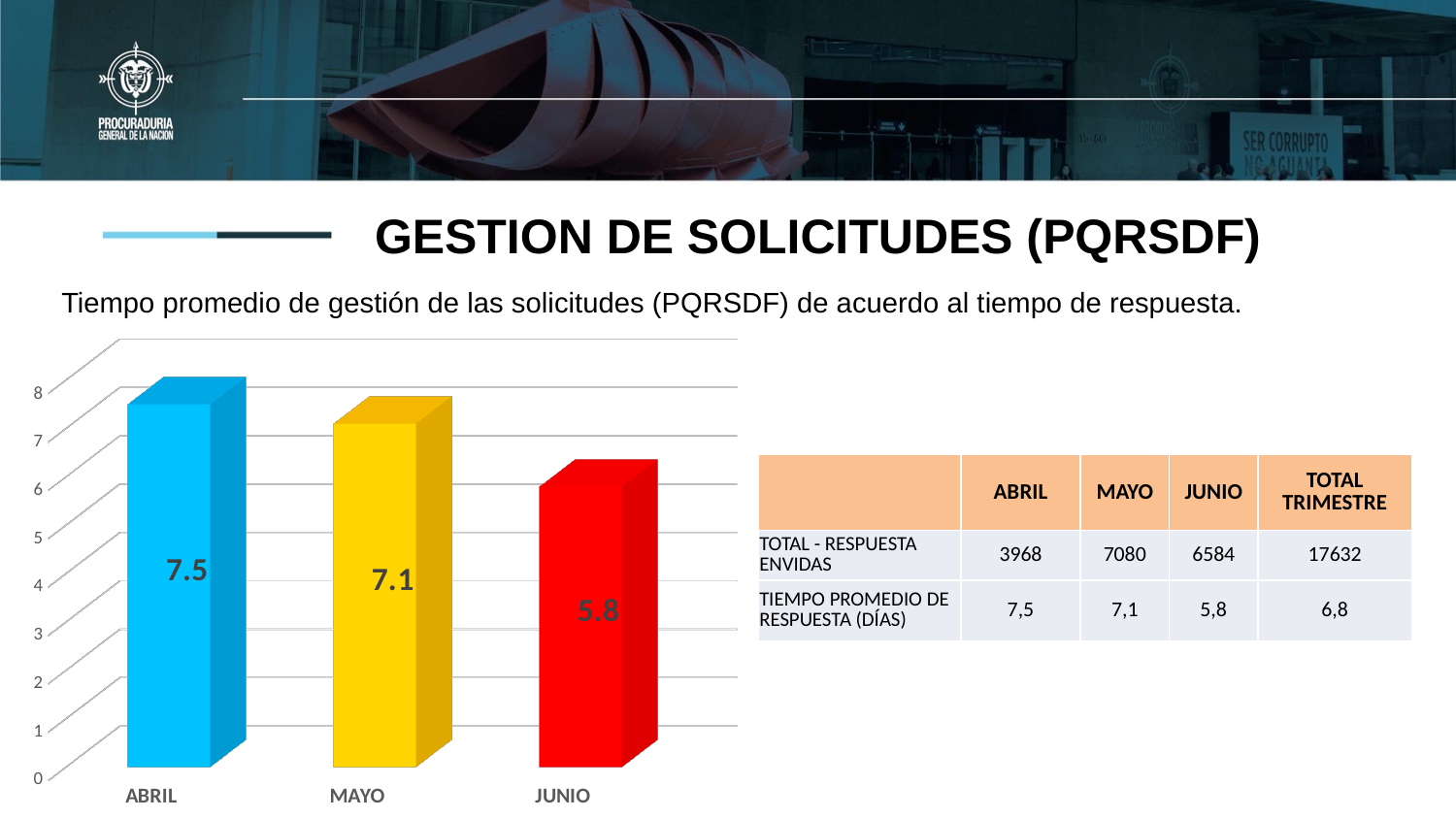
Which month has the highest bar in the chart? ABRIL Which is larger in the bar chart, the value for ABRIL or the value for MAYO? ABRIL How many months are plotted in the bar chart? 3 What is the value shown for MAYO in the bar chart? 7.1 Which month has the lowest bar in the chart? JUNIO Do the values in the bar chart rise or fall from ABRIL to JUNIO? fall What kind of chart is shown on the slide? bar chart Is the value for JUNIO in the bar chart greater or less than 6? less What is the value shown for ABRIL in the bar chart? 7.5 What is the difference between the values for MAYO and JUNIO in the bar chart? 1.3 What is the value shown for JUNIO in the bar chart? 5.8 What is the difference between the values for ABRIL and JUNIO in the bar chart? 1.7